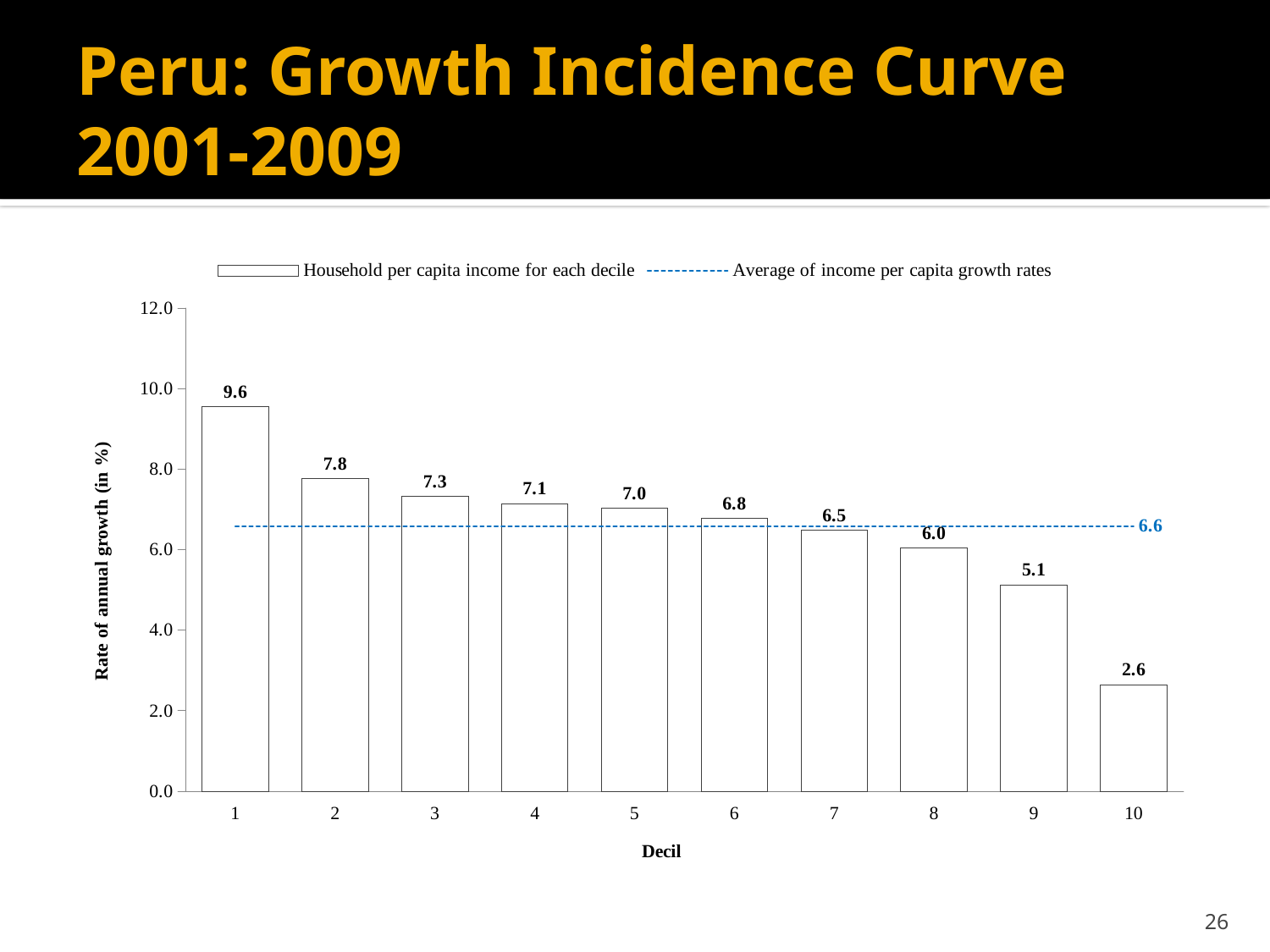
Is the value for decile 9 greater or less than 6.0? less Which decile has the lowest rate of annual growth? 10 Which has a higher rate of annual growth, decile 3 or decile 8? Decile 3 How many deciles are shown on the x axis? 10 Do the growth rates rise or fall as the decile number increases? Fall What is the rate of annual growth for decile 10? 2.6 What value is shown for the average of income per capita growth rates line? 6.6 What is the rate of annual growth for decile 1? 9.6 What is the difference between the growth rates of decile 1 and decile 10? 7.0 How many series does the legend list? 2 What kind of chart is used to show the household per capita income growth for each decile? Bar chart Which decile has the highest rate of annual growth? 1